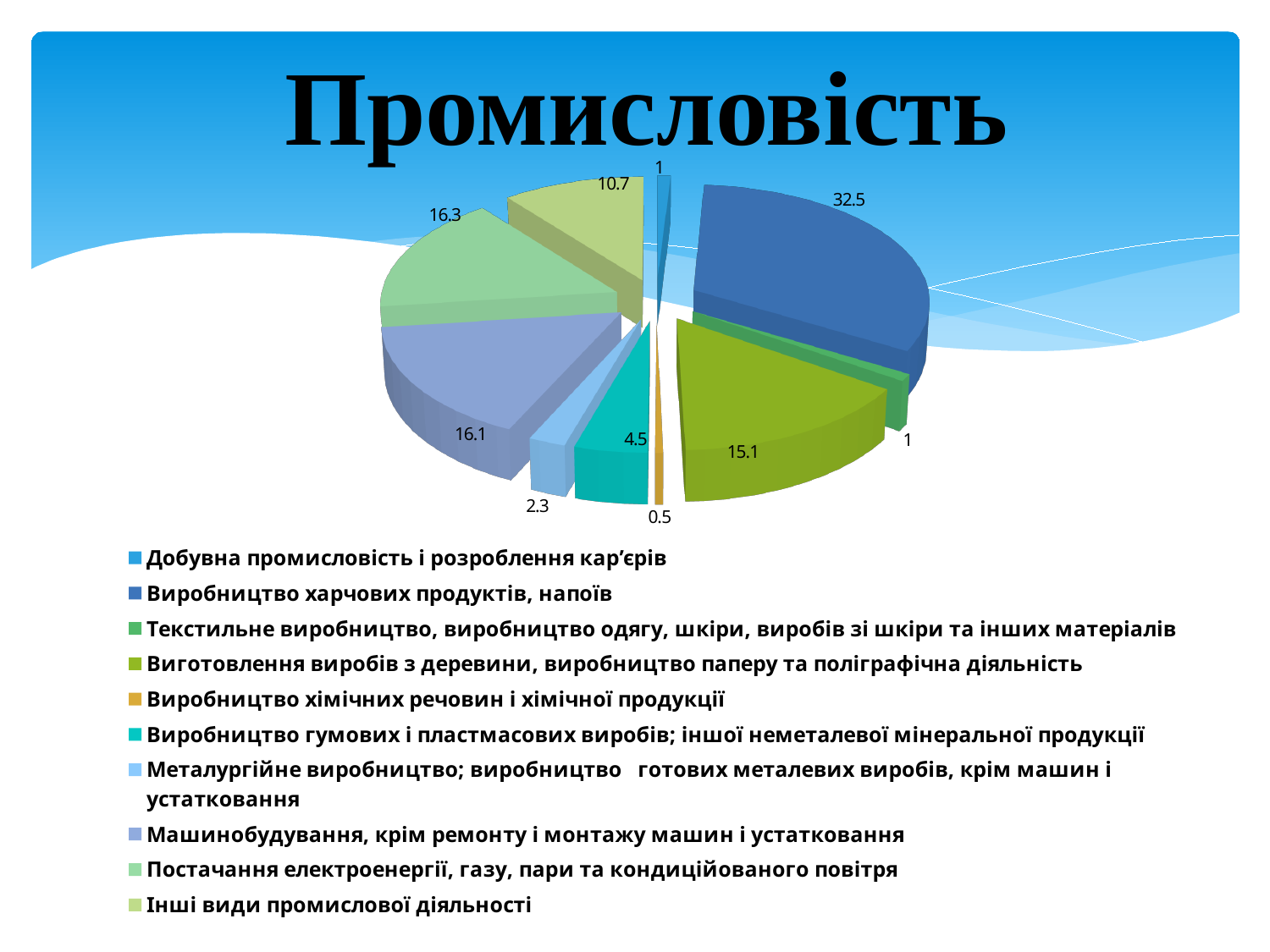
How many categories does the pie chart contain? 10 What is the title of the chart? Промисловість What is the difference between the values for Виробництво харчових продуктів, напоїв and Виготовлення виробів з деревини, виробництво паперу та поліграфічна діяльність? 17.4 What type of chart is shown on the slide? pie chart Which is larger: the value for Виготовлення виробів з деревини, виробництво паперу та поліграфічна діяльність or the value for Інші види промислової діяльності? Виготовлення виробів з деревини, виробництво паперу та поліграфічна діяльність What is the value for Машинобудування, крім ремонту і монтажу машин і устаткування? 16.1 Which category has the smallest slice of the pie? Виробництво хімічних речовин і хімічної продукції What is the value for Виробництво гумових і пластмасових виробів; іншої неметалевої мінеральної продукції? 4.5 What share of the pie does Постачання електроенергії, газу, пари та кондиційованого повітря represent? 16.3 Which category has the largest slice of the pie? Виробництво харчових продуктів, напоїв What is the value for Виробництво харчових продуктів, напоїв? 32.5 What is the value for Інші види промислової діяльності? 10.7